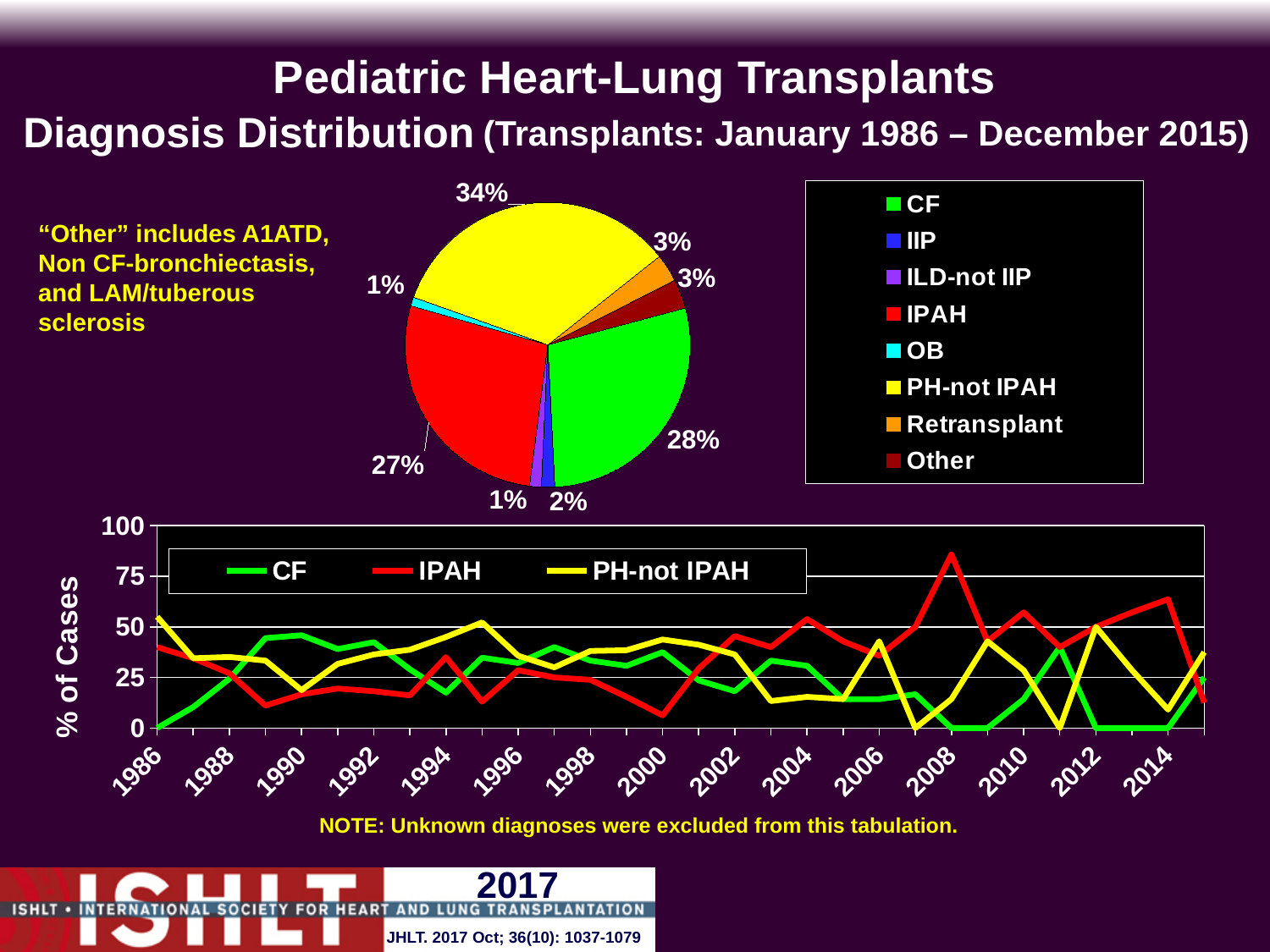
In the pie chart, what is the difference in percentage points between the CF share and the IPAH share? 1% How many diagnosis categories does the pie chart legend list? 8 In the pie chart, which diagnosis has the largest share? PH-not IPAH In the pie chart, what share of pediatric heart-lung transplants is PH-not IPAH? 34% In the pie chart, which is larger, the share for PH-not IPAH or the share for CF? PH-not IPAH In the pie chart, what share of transplants is IPAH? 27% In the lower line chart, is the value for IPAH in 2008 greater or less than 75? greater What is the y-axis label of the lower line chart? % of Cases In the pie chart, what share of transplants is CF? 28% In the lower line chart, is the value for CF in 2010 greater or less than 25? less What kind of chart is the lower chart on the slide? Line chart How many series does the legend of the lower line chart list? 3